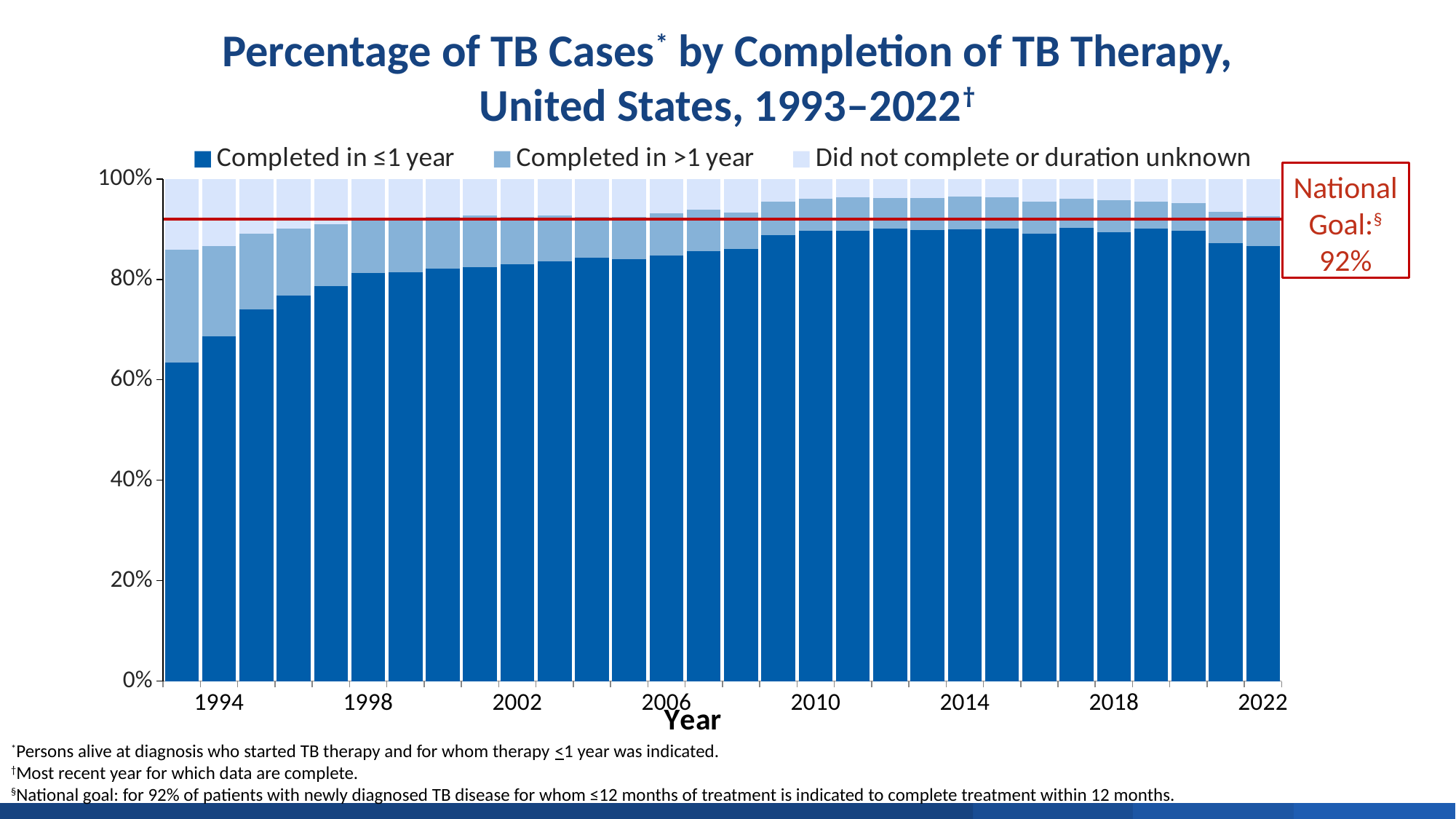
What is the label of the x axis? Year What kind of chart is shown on the slide? Stacked bar chart Which year has the lowest percentage of cases completed in ≤1 year? 1993 How many series does the legend list? 3 Which year has the larger percentage of cases completed in ≤1 year, 1994 or 1995? 1995 Does the percentage of cases completed in ≤1 year generally rise or fall from 1993 to 2010? rise Is the percentage of cases completed in ≤1 year in 2010 greater or less than 80%? greater Is the percentage of cases completed in ≤1 year in 2022 greater or less than 80%? greater How many years (bars) are plotted in the chart? 30 Is the percentage of cases completed in ≤1 year in 1993 greater or less than 80%? less What is the national goal percentage marked by the red line on the chart? 92% Which year has the larger percentage of cases completed in ≤1 year, 1993 or 2022? 2022